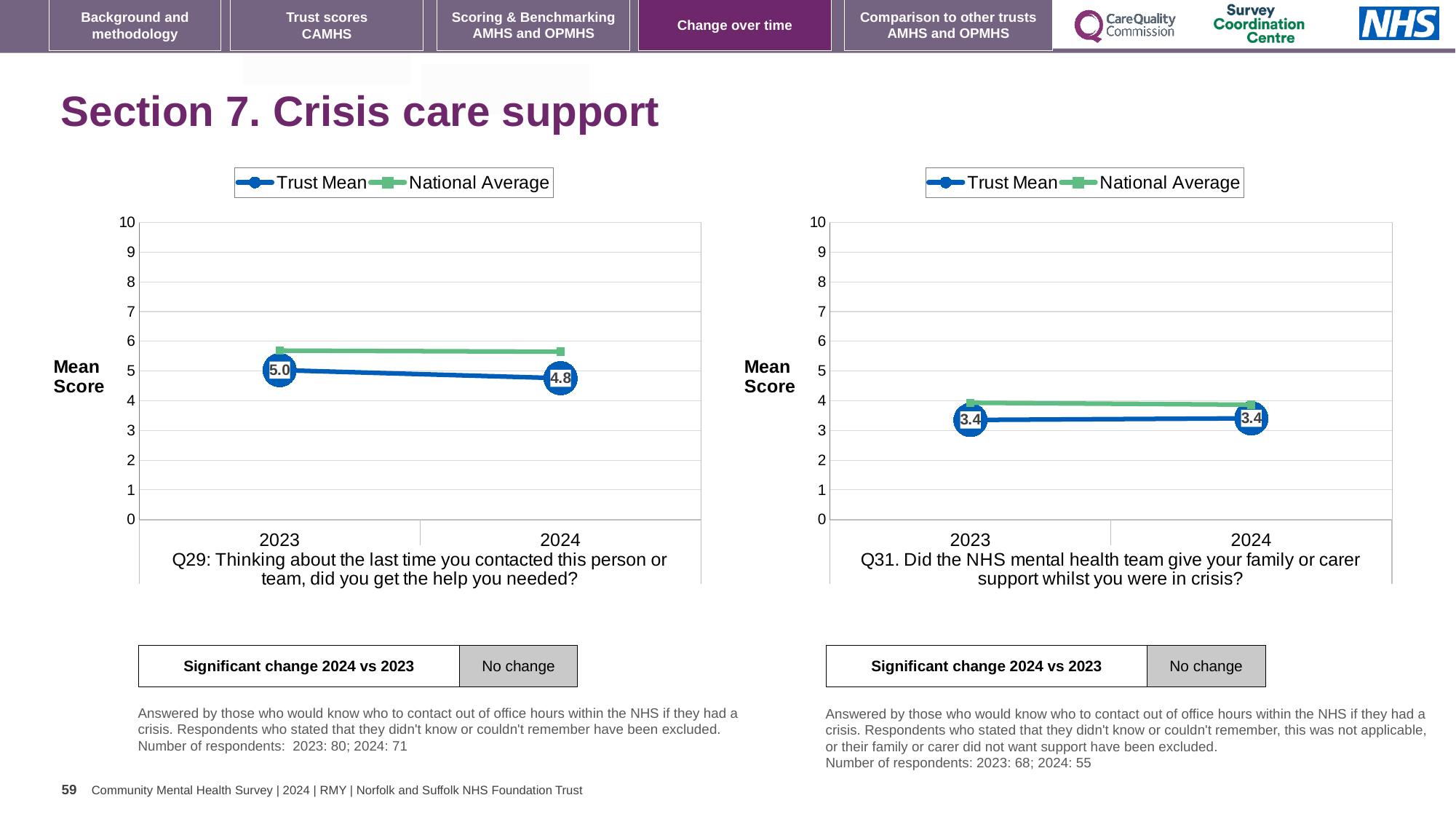
In the left chart (Q29), does the Trust Mean rise or fall from 2023 to 2024? fall In the left chart (Q29), by how much did the Trust Mean change from 2023 to 2024? 0.2 In the left chart (Q29), is the National Average for 2023 greater or less than 5? greater How many series does the legend of the right chart (Q31) list? 2 In the right chart (Q31), is the National Average for 2024 greater or less than 5? less In the left chart (Q29), what is the Trust Mean score for 2024? 4.8 How many years are plotted on the x axis of the left chart (Q29)? 2 In the right chart (Q31), what is the Trust Mean score for 2024? 3.4 In the left chart (Q29), which year has the higher Trust Mean, 2023 or 2024? 2023 In the left chart (Q29), what is the Trust Mean score for 2023? 5.0 What kind of chart is the left chart (Q29)? line chart In the right chart (Q31), does the Trust Mean rise, fall or stay the same from 2023 to 2024? stay the same